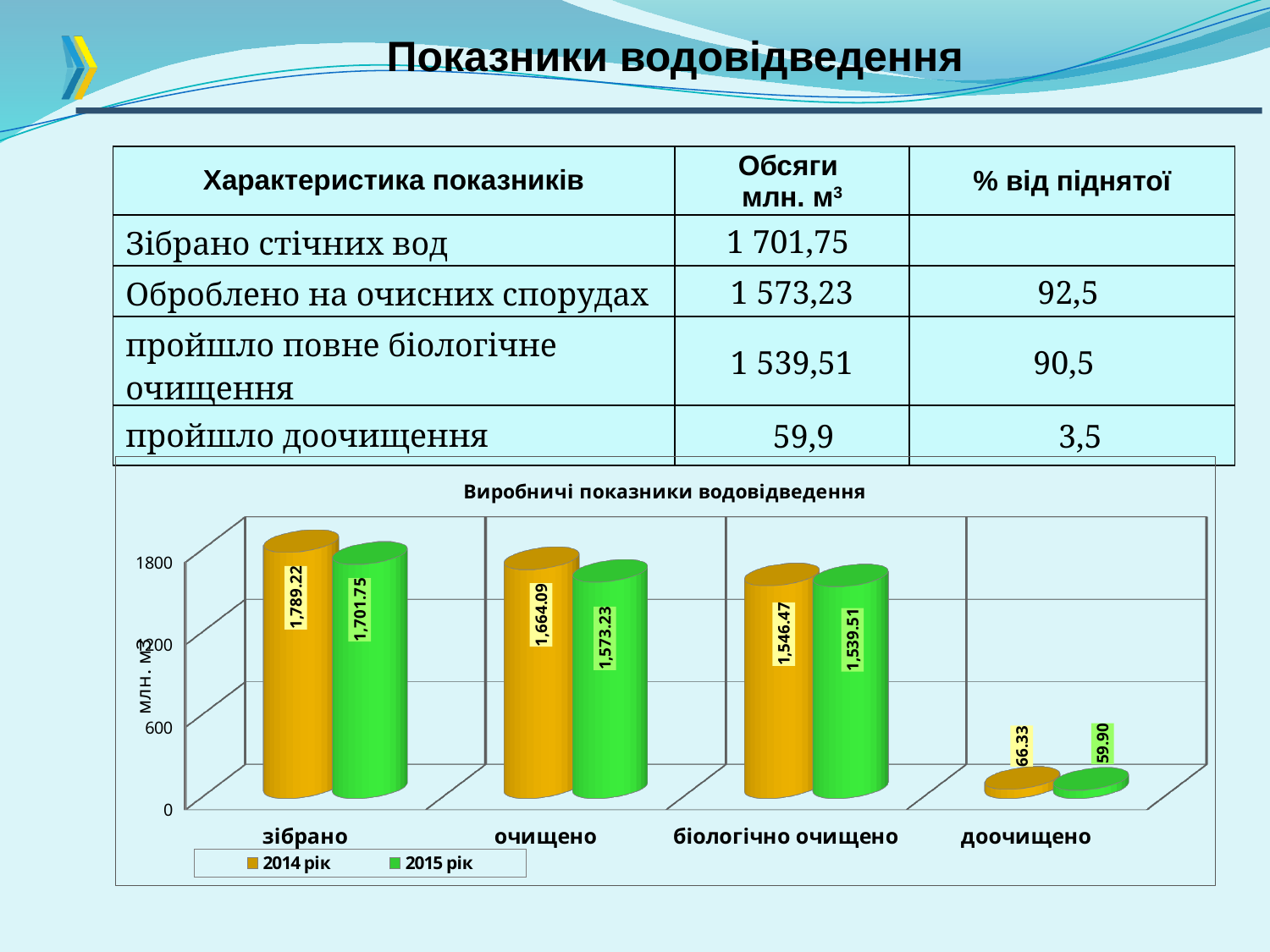
How many categories are shown on the x axis of the chart? 4 What is the value for 2015 рік in the очищено category? 1,573.23 Which category has the highest value for 2014 рік? зібрано What is the difference between the 2014 рік and 2015 рік values for доочищено? 6.43 Which category has the lowest value for 2015 рік? доочищено How many series does the chart legend list? 2 What is the difference between the 2014 рік and 2015 рік values for зібрано? 87.47 What is the value for 2014 рік in the зібрано category? 1,789.22 What is the title of the chart? Виробничі показники водовідведення What is the value for 2015 рік in the доочищено category? 59.90 What is the value for 2014 рік in the біологічно очищено category? 1,546.47 Which is larger: the 2014 рік value for очищено or the 2015 рік value for очищено? 2014 рік